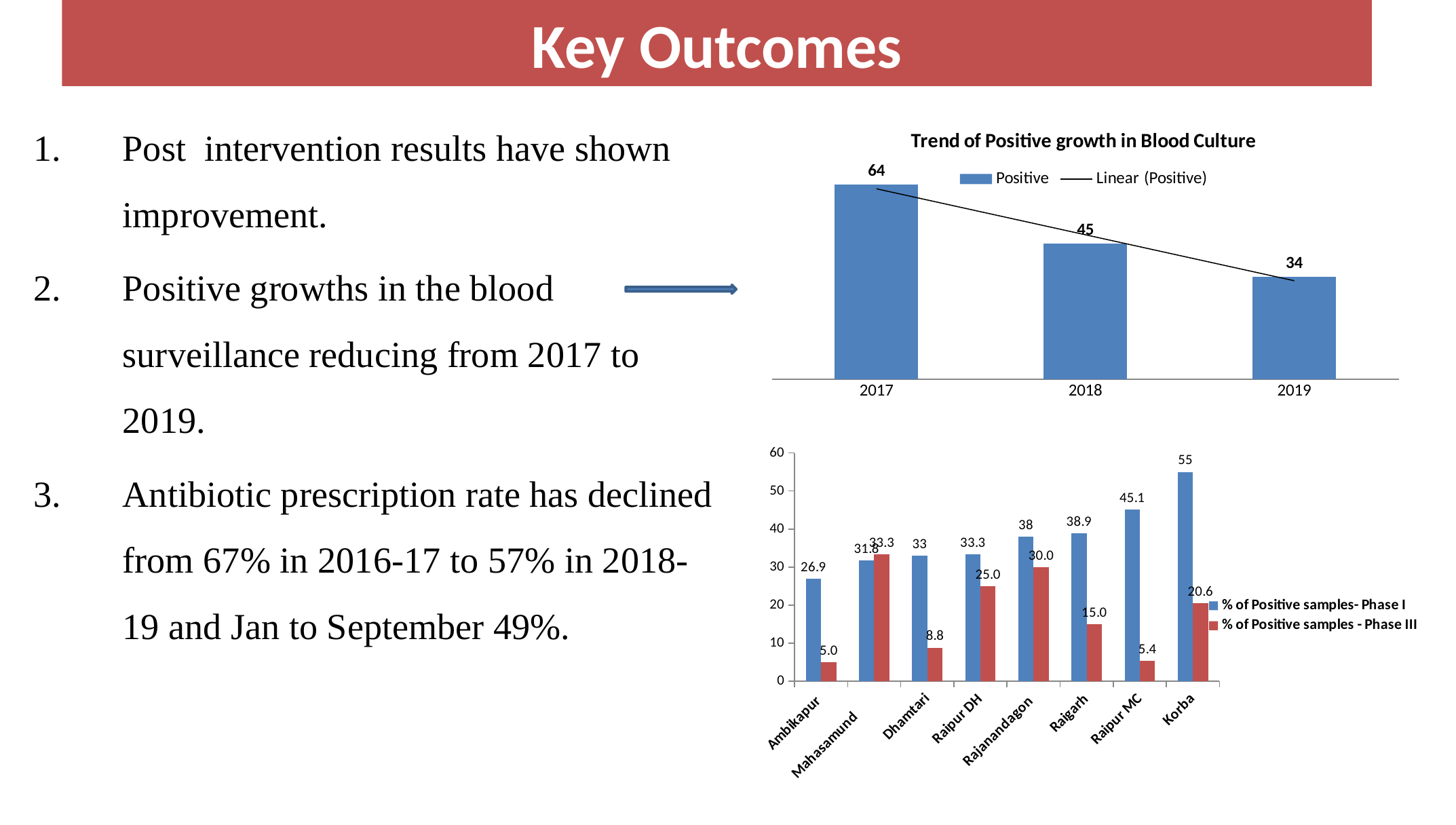
In the bottom chart, how many series does the legend list? 2 In the 'Trend of Positive growth in Blood Culture' chart, what is the Positive value for 2019? 34 In the bottom chart, which is larger for Raigarh: the Phase I value or the Phase III value? Phase I In the bottom chart, what is the '% of Positive samples- Phase I' value for Korba? 55 In the bottom chart, which district has the highest '% of Positive samples- Phase I' value? Korba In the bottom chart, which district has the lowest '% of Positive samples - Phase III' value? Ambikapur In the 'Trend of Positive growth in Blood Culture' chart, do the values rise or fall from 2017 to 2019? fall In the 'Trend of Positive growth in Blood Culture' chart, how many years are shown on the x axis? 3 In the bottom chart, what is the '% of Positive samples - Phase III' value for Dhamtari? 8.8 In the bottom chart, what is the difference between the Phase I and Phase III values for Raipur MC? 39.7 In the 'Trend of Positive growth in Blood Culture' chart, what is the Positive value for 2017? 64 In the 'Trend of Positive growth in Blood Culture' chart, what is the difference between the 2017 and 2018 values? 19